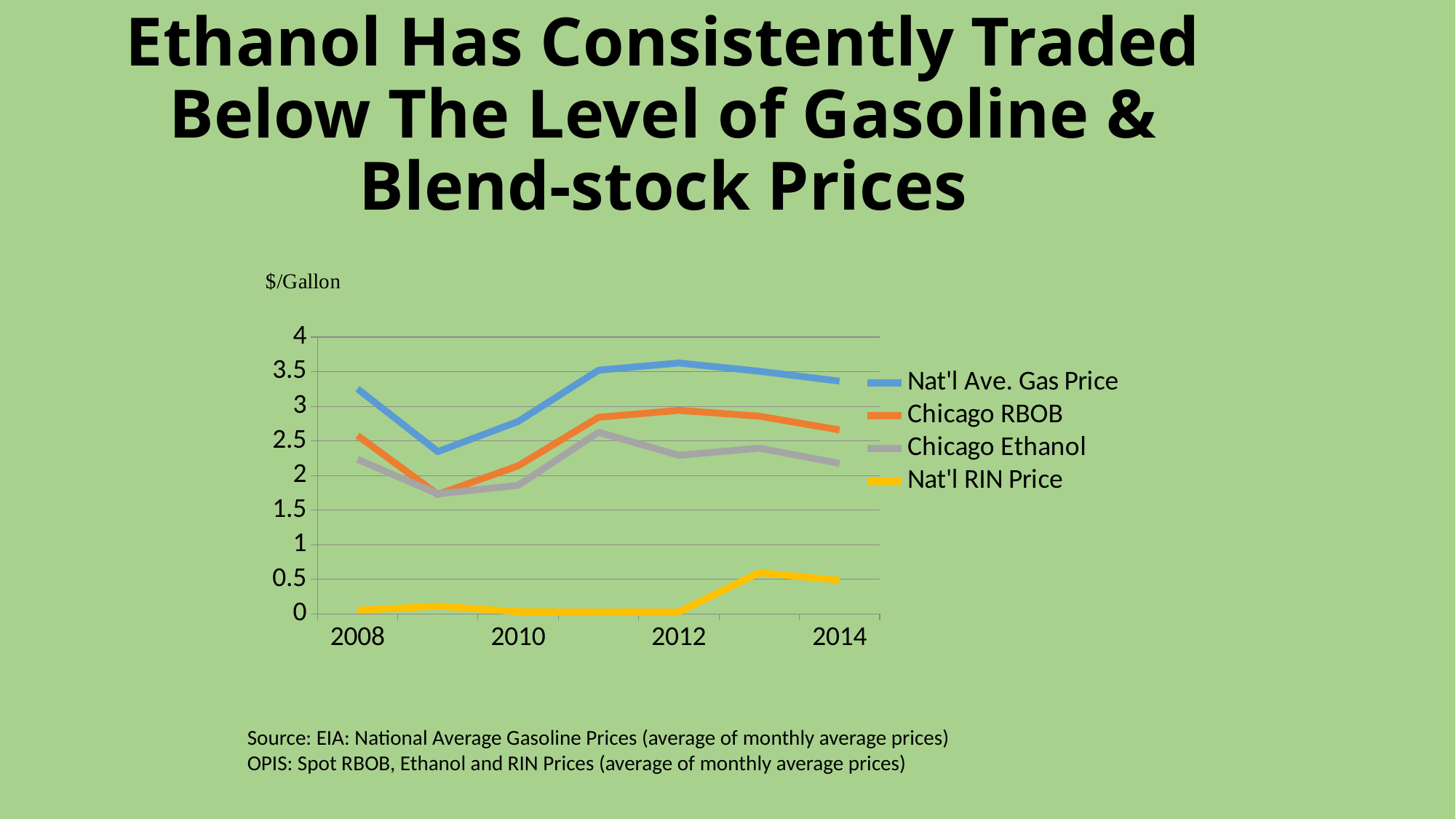
In which year does the Nat'l Ave. Gas Price line reach its highest point? 2012 Which series has the highest value in 2012? Nat'l Ave. Gas Price Does the Nat'l Ave. Gas Price line rise or fall from 2012 to 2014? fall How many series does the legend list? 4 Which series has the lowest values across all years shown? Nat'l RIN Price Is the value for Chicago Ethanol in 2014 greater or less than 2.5? less In which year does the Nat'l Ave. Gas Price line reach its lowest point? 2009 What kind of chart is shown on the slide? line chart In 2011, which is larger: Chicago RBOB or Chicago Ethanol? Chicago RBOB Is the value for Chicago RBOB in 2009 greater or less than 2? less How many year labels appear on the x axis? 4 Is the value for Nat'l Ave. Gas Price in 2008 greater or less than 3? greater